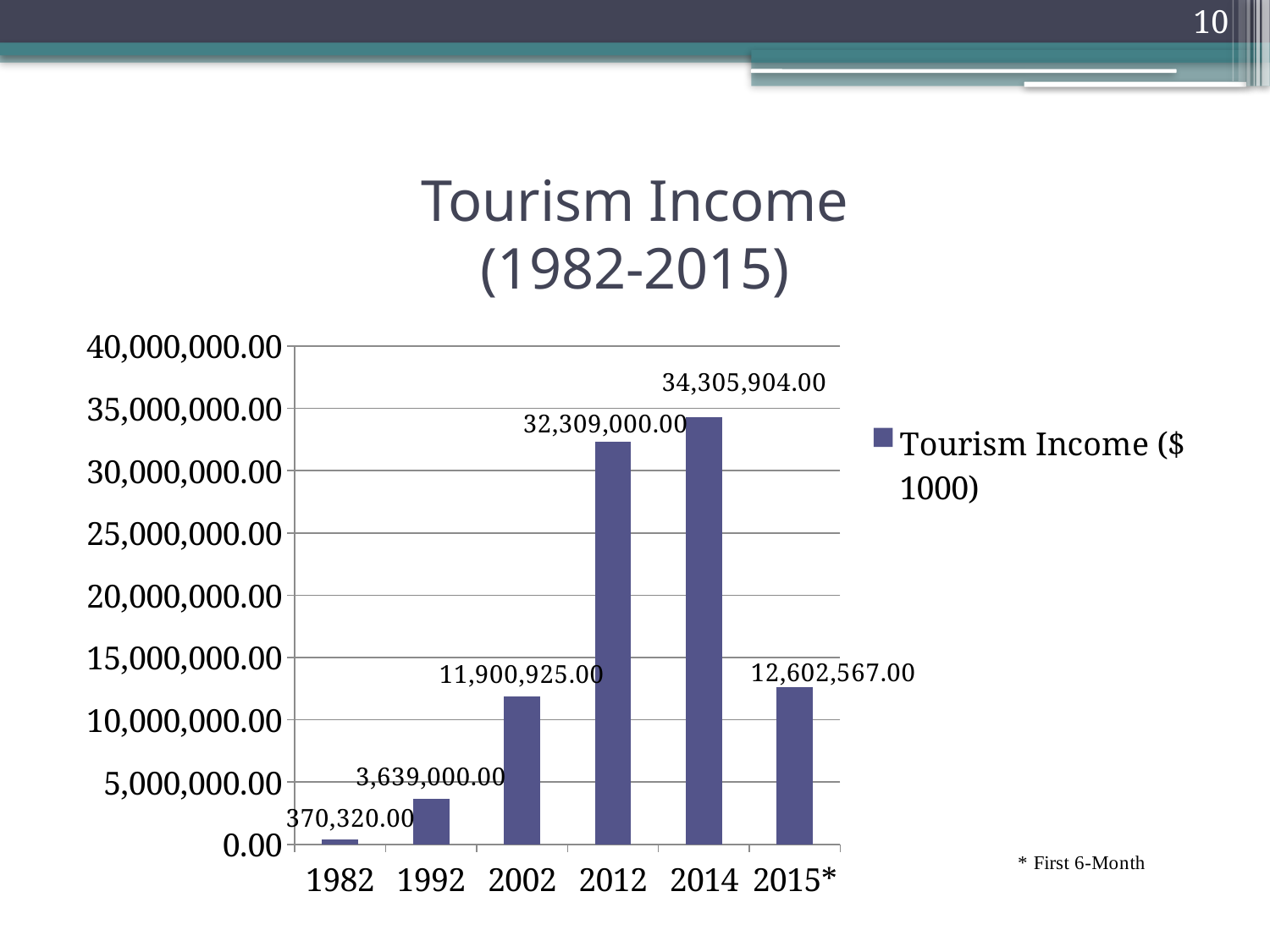
What is the tourism income value shown for 1982? 370,320.00 What type of chart is shown on the slide? bar chart Which year has the lowest tourism income? 1982 What is the legend entry for the series in the chart? Tourism Income ($ 1000) Which is larger, the tourism income for 2002 or for 2015*? 2015* What is the difference between the tourism income for 2014 and 2012? 1,996,904.00 Which year has the highest tourism income? 2014 Is the value for 1992 greater or less than 5,000,000.00? less What is the tourism income value shown for 2012? 32,309,000.00 How many years are shown on the x axis? 6 What is the difference between the tourism income for 2015* and 2002? 701,642.00 What is the tourism income value shown for 2015*? 12,602,567.00